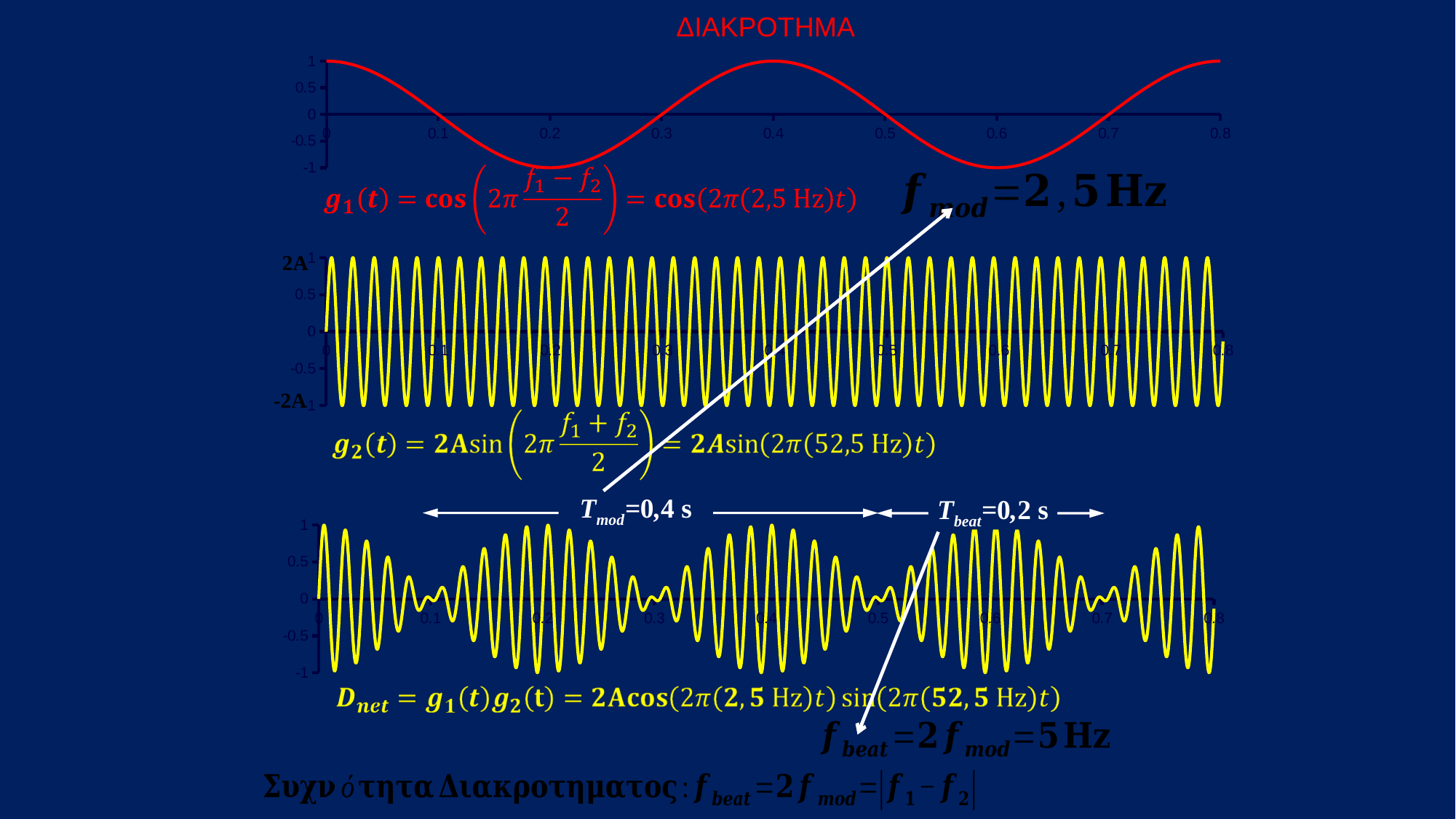
What is the maximum value shown on the x axis of the top chart? 0.8 In the top chart, is the value of the red curve at x = 0.3 greater or less than 0.5? less How many charts are shown on the slide? 3 In the top chart, at which x value does the red curve first cross zero? 0.1 In the top chart, does the red curve rise or fall between x = 0.2 and x = 0.4? rise In the top chart, what is the value of the red curve at x = 0.6? -1 In the top chart, does the red curve rise or fall between x = 0 and x = 0.2? fall What colour is the curve in the middle chart? yellow In the top chart, what is the value of the red curve at x = 0.4? 1 In the top chart, what is the value of the red curve at x = 0.2? -1 In the top chart, what is the value of the red curve at x = 0? 1 What kind of chart is the top chart on the slide? line chart